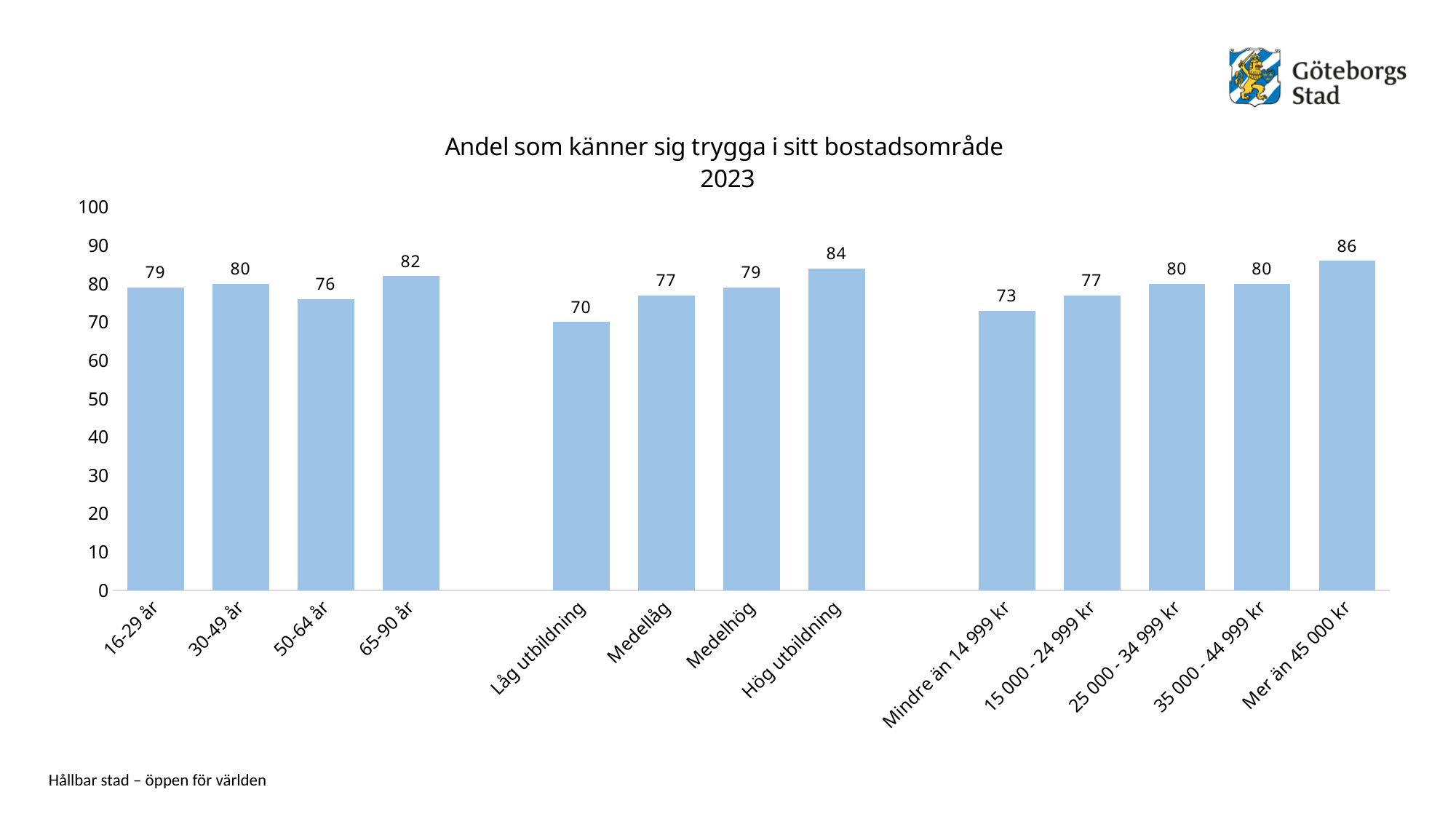
What is the value for Hög utbildning? 84 What is the value for Mindre än 14 999 kr? 73 Which is larger, the value for 65-90 år or the value for 50-64 år? 65-90 år How many categories are shown on the x axis? 13 Which category has the highest value? Mer än 45 000 kr Which category has the lowest value? Låg utbildning What kind of chart is this? Bar chart What is the value for 16-29 år? 79 Do the values rise or fall across the income categories from Mindre än 14 999 kr to Mer än 45 000 kr? Rise What is the value for Låg utbildning? 70 What is the title of the chart? Andel som känner sig trygga i sitt bostadsområde 2023 What is the difference between the values for Hög utbildning and Låg utbildning? 14